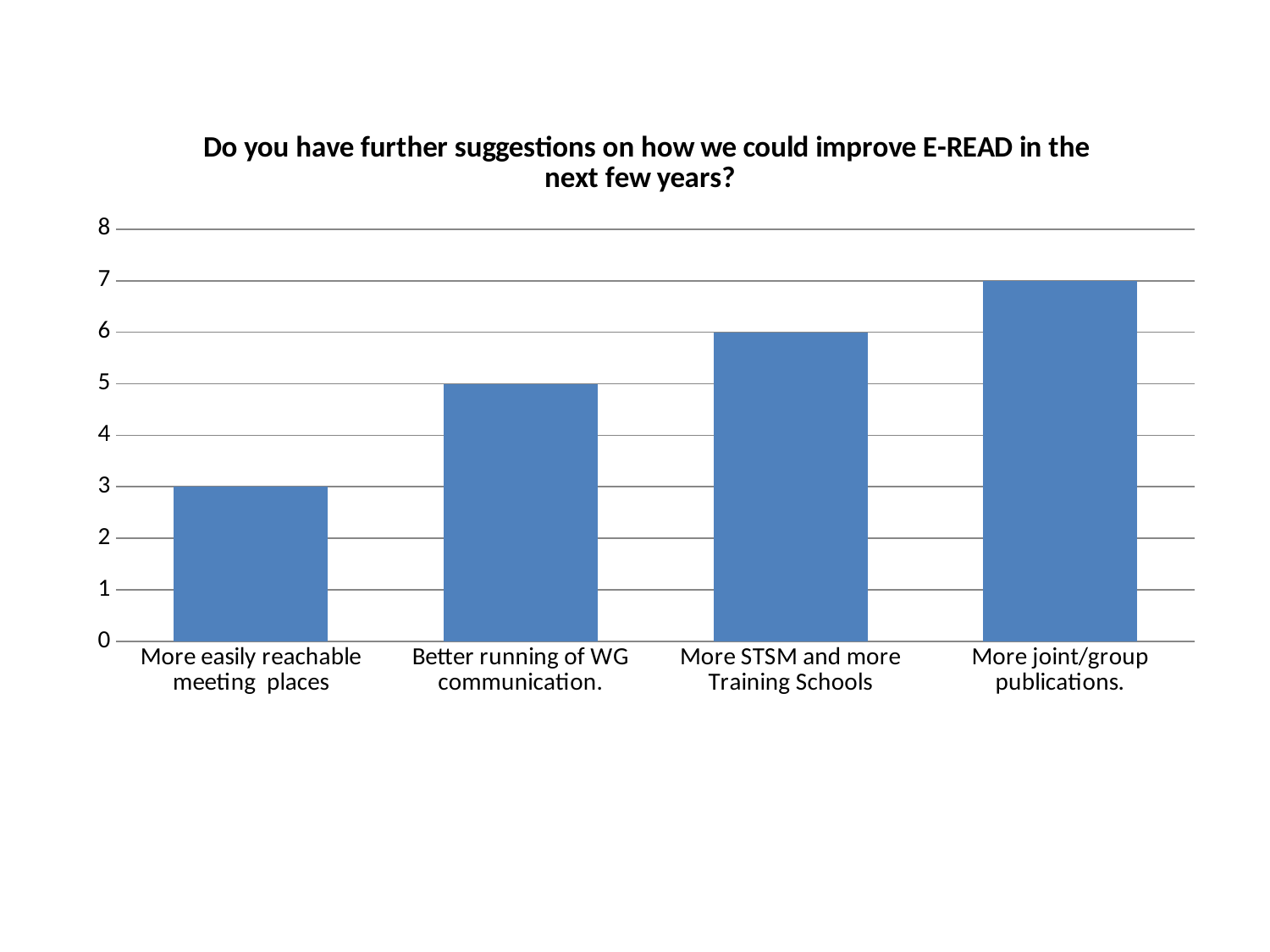
Which category has the highest value? More joint/group publications. Which is larger, the value for "Better running of WG communication." or the value for "More STSM and more Training Schools"? More STSM and more Training Schools What is the value for "More STSM and more Training Schools"? 6 Is the value for "More easily reachable meeting places" greater or less than 4? less Which category has the lowest value? More easily reachable meeting places What is the value for "More joint/group publications."? 7 What kind of chart is shown on the slide? bar chart Do the values rise or fall from left to right along the x axis? rise What is the value for "More easily reachable meeting places"? 3 How many categories are shown on the x axis? 4 What is the value for "Better running of WG communication."? 5 What is the difference between the values for "More joint/group publications." and "More easily reachable meeting places"? 4